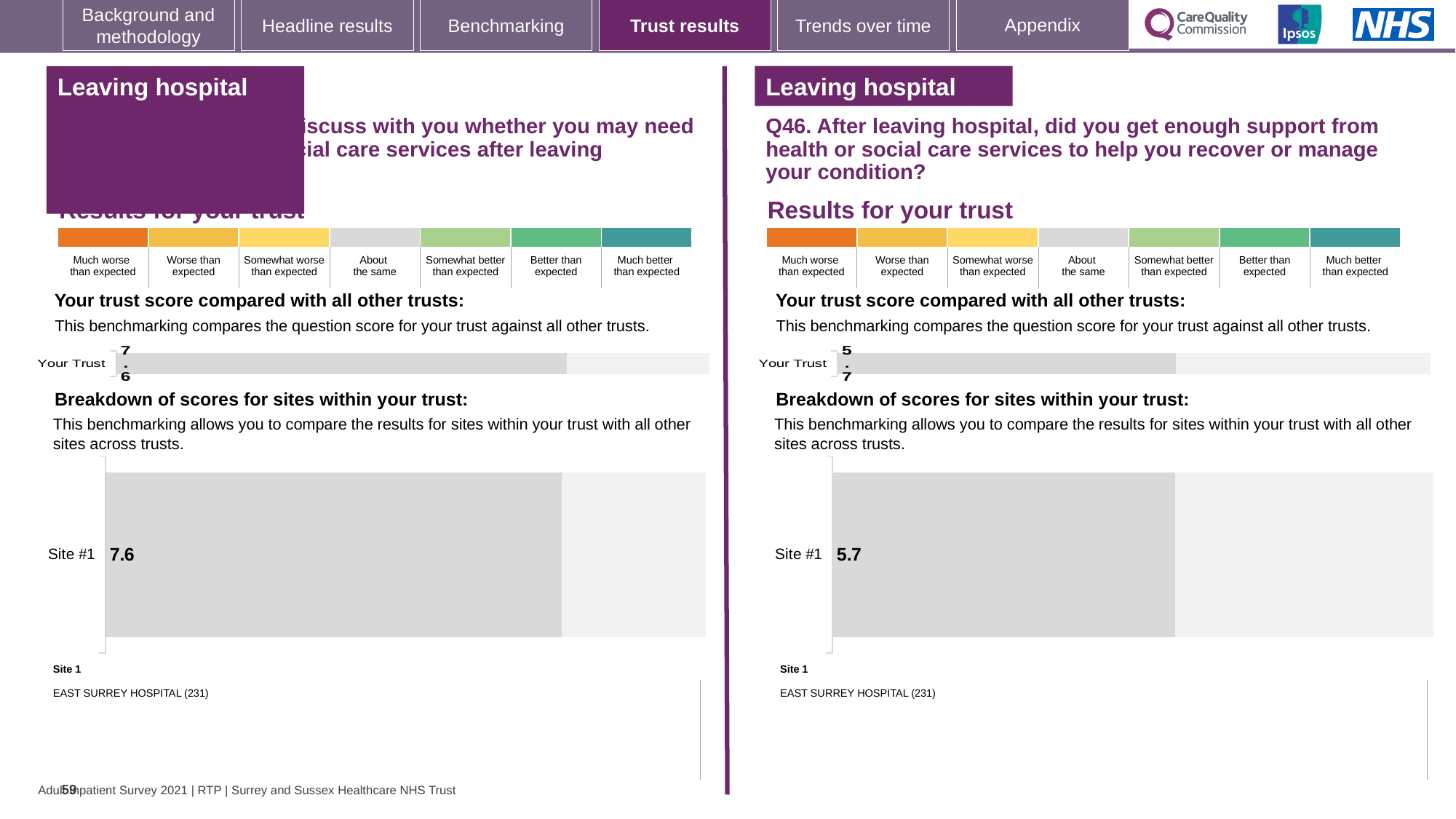
On the left-hand panel, what is the score shown for Site #1? 7.6 On the left-hand panel, what is the score shown for Your Trust? 7.6 What type of chart is used to show the Site #1 score on the right-hand panel (Q46)? Bar chart How many categories are shown in the colour scale key above the Your Trust chart on the right-hand panel (Q46)? 7 What is the difference between the Site #1 score on the left-hand panel and the Site #1 score on the right-hand panel (Q46)? 1.9 On the right-hand panel (Q46), what is the score shown for Site #1? 5.7 Which hospital is listed as Site 1 on the right-hand panel (Q46)? EAST SURREY HOSPITAL (231) How many sites are shown in the site breakdown chart on the left-hand panel? 1 What is the difference between the Your Trust score on the left-hand panel and the Your Trust score on the right-hand panel (Q46)? 1.9 Which is larger: the Site #1 score on the left-hand panel or the Site #1 score on the right-hand panel (Q46)? Left-hand panel How many sites are shown in the site breakdown chart on the right-hand panel (Q46)? 1 On the right-hand panel (Q46), what is the score shown for Your Trust? 5.7